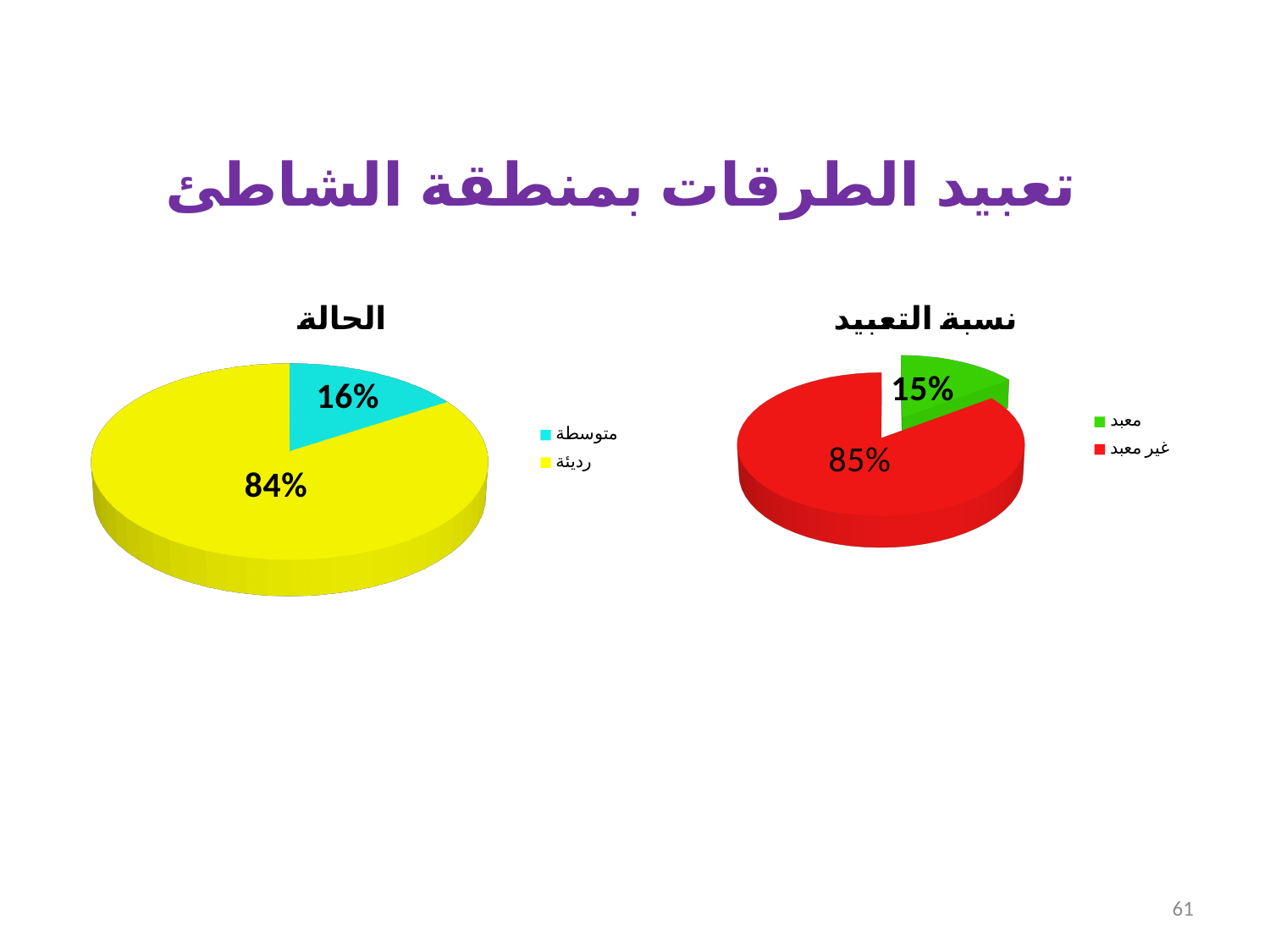
In the chart titled "الحالة", which category has the smallest slice? متوسطة In the chart titled "نسبة التعبيد", what share of the pie is "معبد"? 15% How many categories does the legend of the chart titled "الحالة" list? 2 In the chart titled "الحالة", what is the difference between the shares of "رديئة" and "متوسطة"? 68% In the chart titled "الحالة", what share of the pie is "رديئة"? 84% What type of chart is the chart titled "نسبة التعبيد"? Pie chart In the chart titled "نسبة التعبيد", what colour is the "معبد" slice? Green In the chart titled "نسبة التعبيد", what is the difference between the shares of "غير معبد" and "معبد"? 70% In the chart titled "الحالة", what share of the pie is "متوسطة"? 16% In the chart titled "الحالة", which is larger: "متوسطة" or "رديئة"? رديئة In the chart titled "نسبة التعبيد", which category has the largest slice? غير معبد